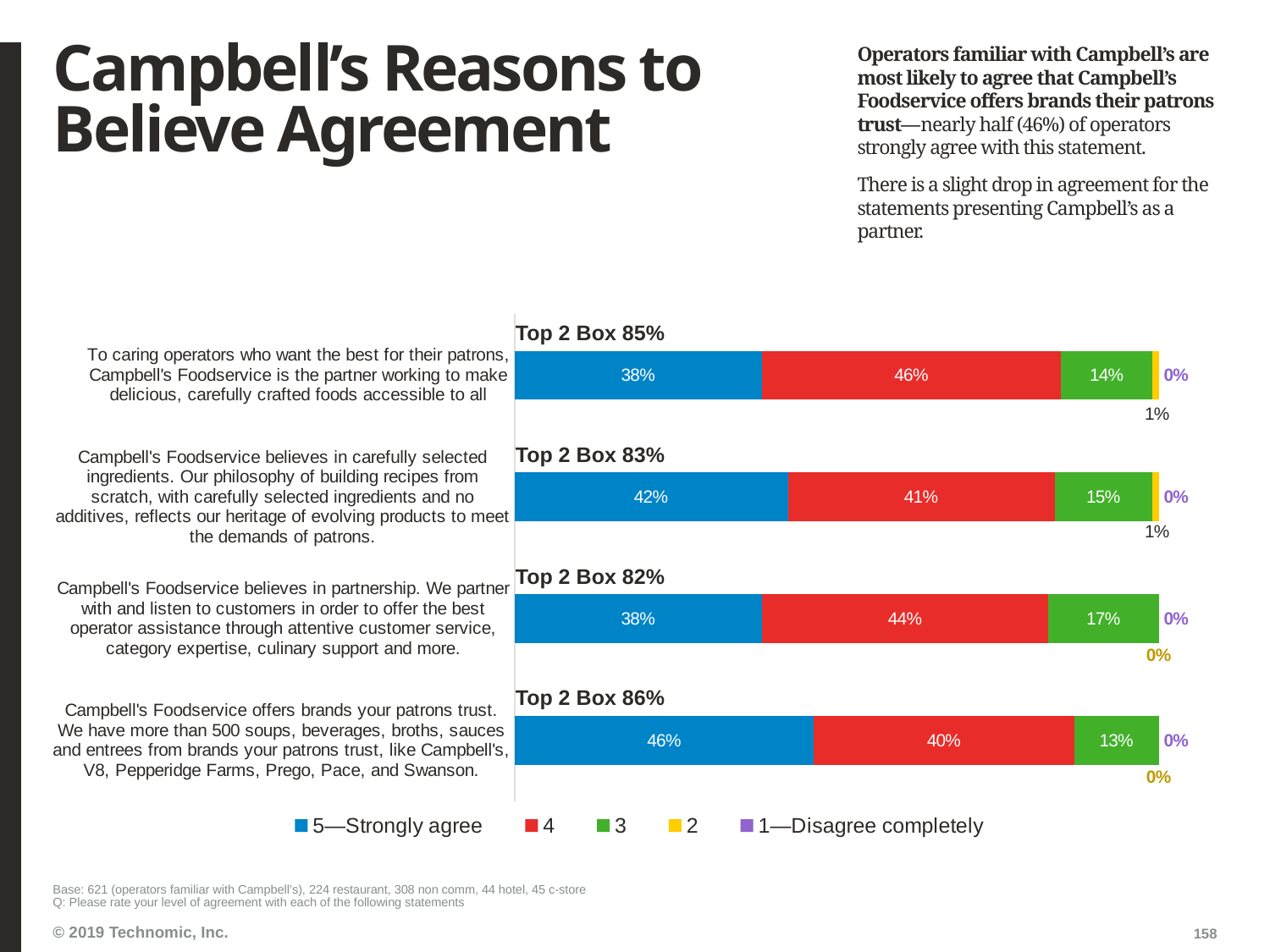
Which is larger: the rating-3 share for the partnership statement or the rating-3 share for the brands-your-patrons-trust statement? The partnership statement (17%) What label does the legend give to the purple series? 1—Disagree completely Which statement has the lowest Top 2 Box score? Campbell's Foodservice believes in partnership Which statement has the highest Top 2 Box score? Campbell's Foodservice offers brands your patrons trust What is the difference in the 'Strongly agree' percentage between the brands-your-patrons-trust statement (46%) and the partnership statement (38%)? 8 percentage points What percentage gave a rating of 4 for the statement that Campbell's Foodservice believes in partnership? 44% How many statements (bars) are plotted in the chart? 4 What percentage of operators strongly agree (5) that Campbell's Foodservice offers brands their patrons trust? 46% How many series does the legend list? 5 What is the Top 2 Box score for the statement that Campbell's Foodservice is the partner working to make delicious, carefully crafted foods accessible to all? 85% What kind of chart is shown on the slide? Stacked bar chart What percentage gave a rating of 3 for the statement about carefully selected ingredients? 15%